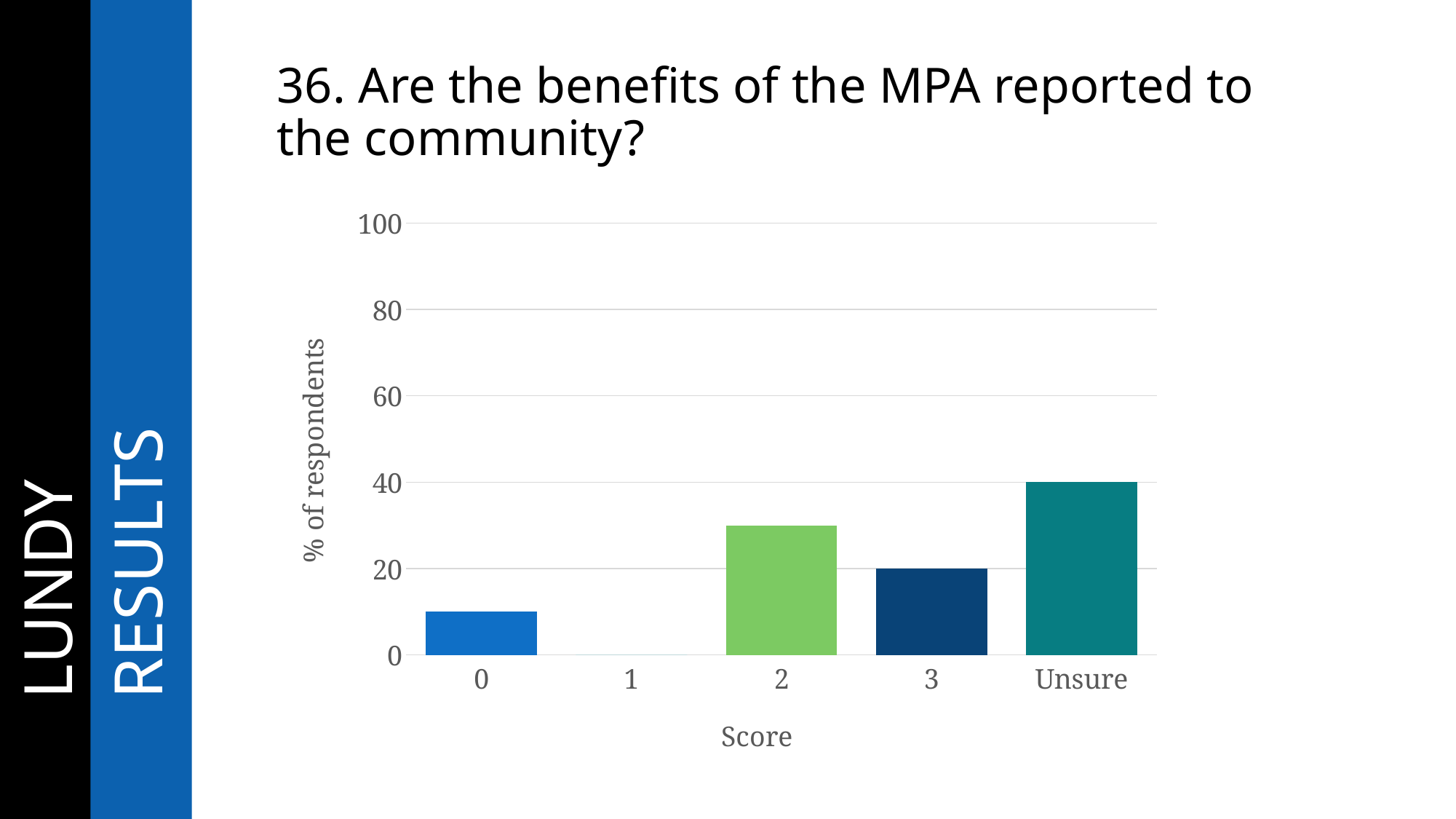
What is the label on the x axis? Score Which has a higher percentage of respondents, score 2 or score 3? 2 Is the value for score 2 greater or less than 20? greater What is the difference between the percentage for Unsure and the percentage for score 3? 20 What is the label on the y axis? % of respondents Is the value for score 0 greater or less than 20? less What percentage of respondents gave a score of 3? 20 What type of chart is shown on the slide? bar chart How many score categories are shown on the x axis? 5 Which score category has the highest percentage of respondents? Unsure What percentage of respondents answered Unsure? 40 Which score category has the lowest percentage of respondents? 1